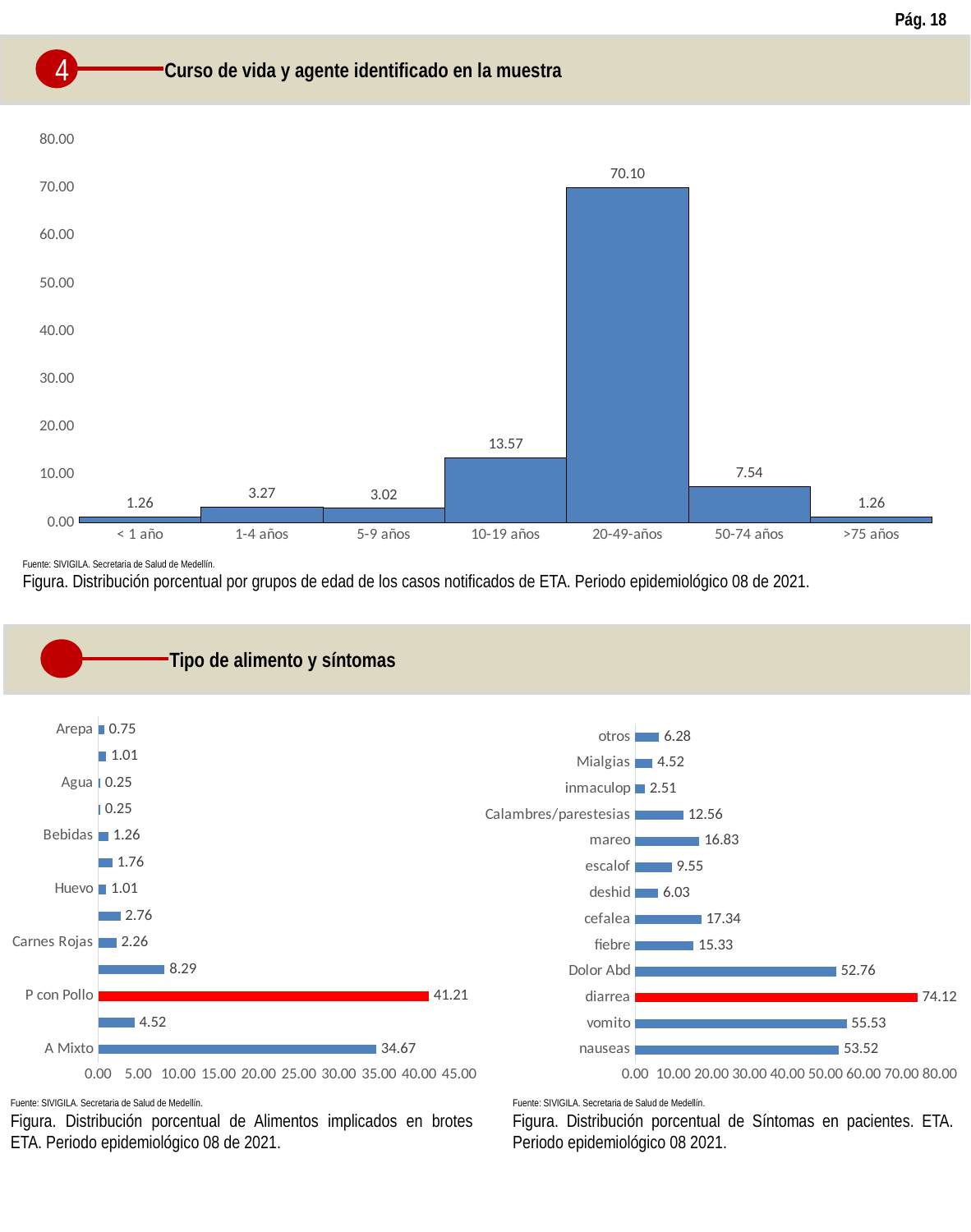
In the bottom-right chart (symptoms), how many symptoms are listed? 13 In the bottom-left chart (foods), what is the value for P con Pollo? 41.21 In the bottom-right chart (symptoms), which symptom has the lowest value? inmaculop In the top chart (age groups), what is the difference between the values for 50-74 años and 1-4 años? 4.27 In the top chart (age groups), which age group has the highest value? 20-49-años In the bottom-right chart (symptoms), which is larger, vomito or nauseas? vomito In the top chart (age groups), what is the value for 10-19 años? 13.57 What type of chart is the top chart (age groups)? Bar chart In the top chart (age groups), how many age groups are shown? 7 In the bottom-left chart (foods), what is the difference between the values for P con Pollo and A Mixto? 6.54 In the top chart (age groups), what is the value for 20-49-años? 70.10 In the bottom-right chart (symptoms), what is the value for diarrea? 74.12